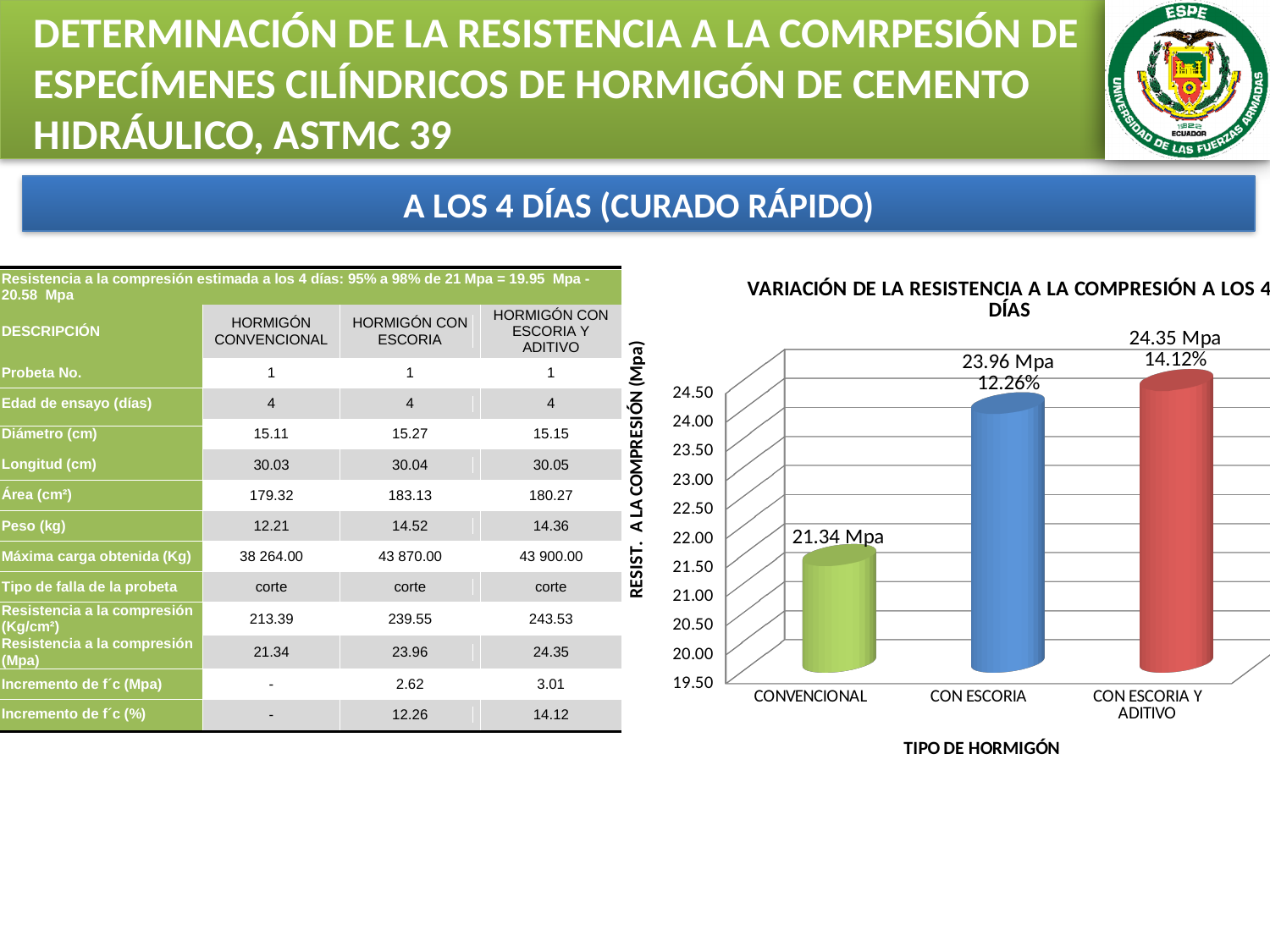
What is the value for CON ESCORIA Y ADITIVO in the chart? 24.35 Mpa Which is larger, the value for CON ESCORIA or the value for CONVENCIONAL? CON ESCORIA Is the value for CONVENCIONAL greater or less than 22.00? less What kind of chart is shown on the slide? bar chart How many types of concrete are shown on the x axis of the chart? 3 What is the title of the chart's x axis? TIPO DE HORMIGÓN What percentage increase is labelled on the CON ESCORIA Y ADITIVO bar? 14.12% Which type of concrete has the highest compressive strength in the chart? CON ESCORIA Y ADITIVO What is the value for CON ESCORIA in the chart? 23.96 Mpa What is the value for CONVENCIONAL in the chart? 21.34 Mpa What is the difference in Mpa between CON ESCORIA Y ADITIVO and CONVENCIONAL? 3.01 Mpa Which type of concrete has the lowest compressive strength in the chart? CONVENCIONAL